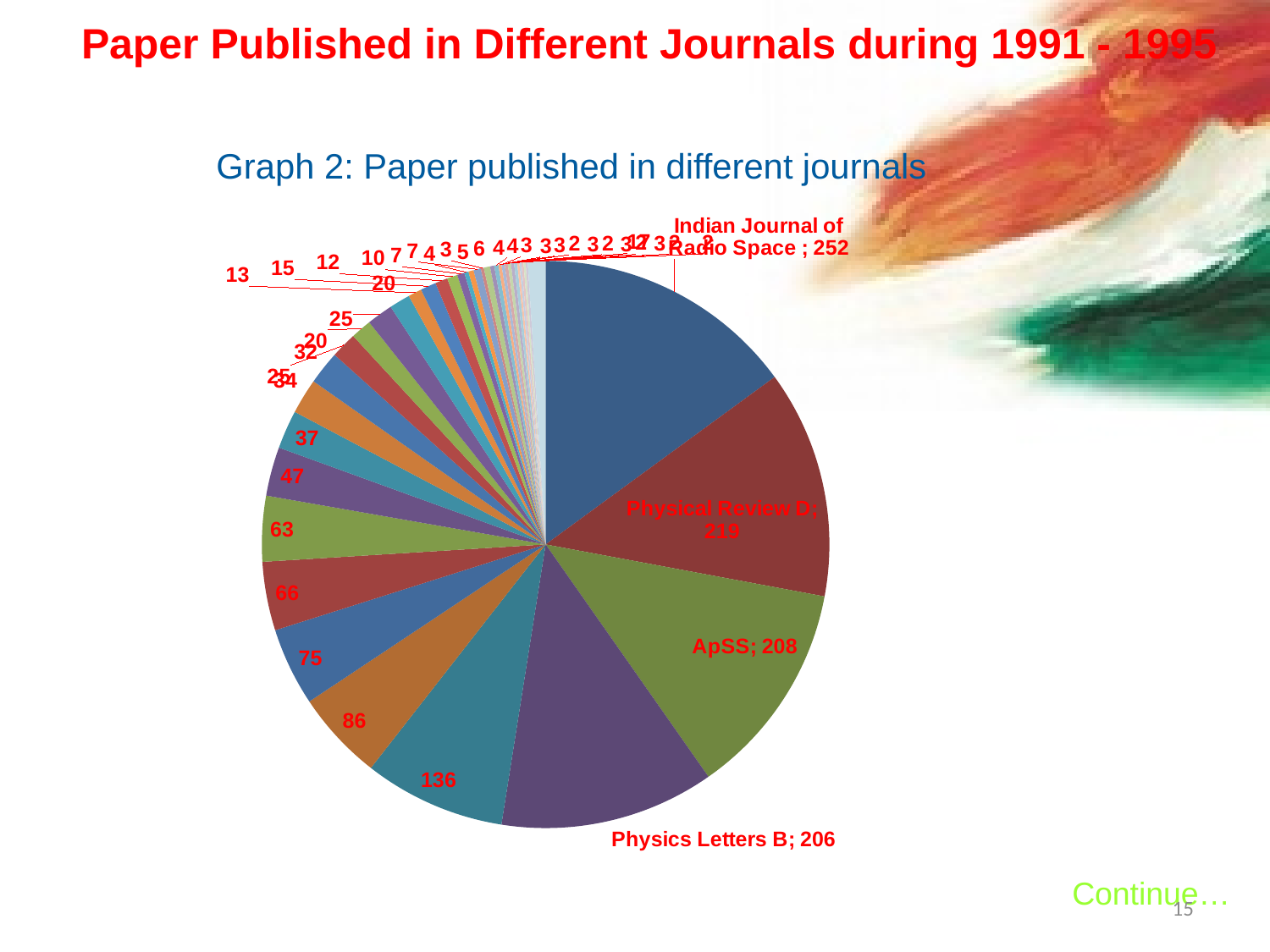
How many papers were published in the Indian Journal of Radio Space according to the pie chart? 252 Which has a larger value in the pie chart, Physical Review D or ApSS? Physical Review D What value is shown for Physical Review D in the pie chart? 219 How many papers were published in Physics Letters B according to the pie chart? 206 What is the difference between the values for Indian Journal of Radio Space and Physical Review D? 33 What value is shown for ApSS in the pie chart? 208 What is the difference between the values for ApSS and Physics Letters B? 2 Which journal has the largest slice in the pie chart? Indian Journal of Radio Space What is the title of the chart on the slide? Graph 2: Paper published in different journals Which has a larger value in the pie chart, Indian Journal of Radio Space or Physics Letters B? Indian Journal of Radio Space What type of chart is shown on the slide? Pie chart What is the difference between the values for Physical Review D and ApSS? 11